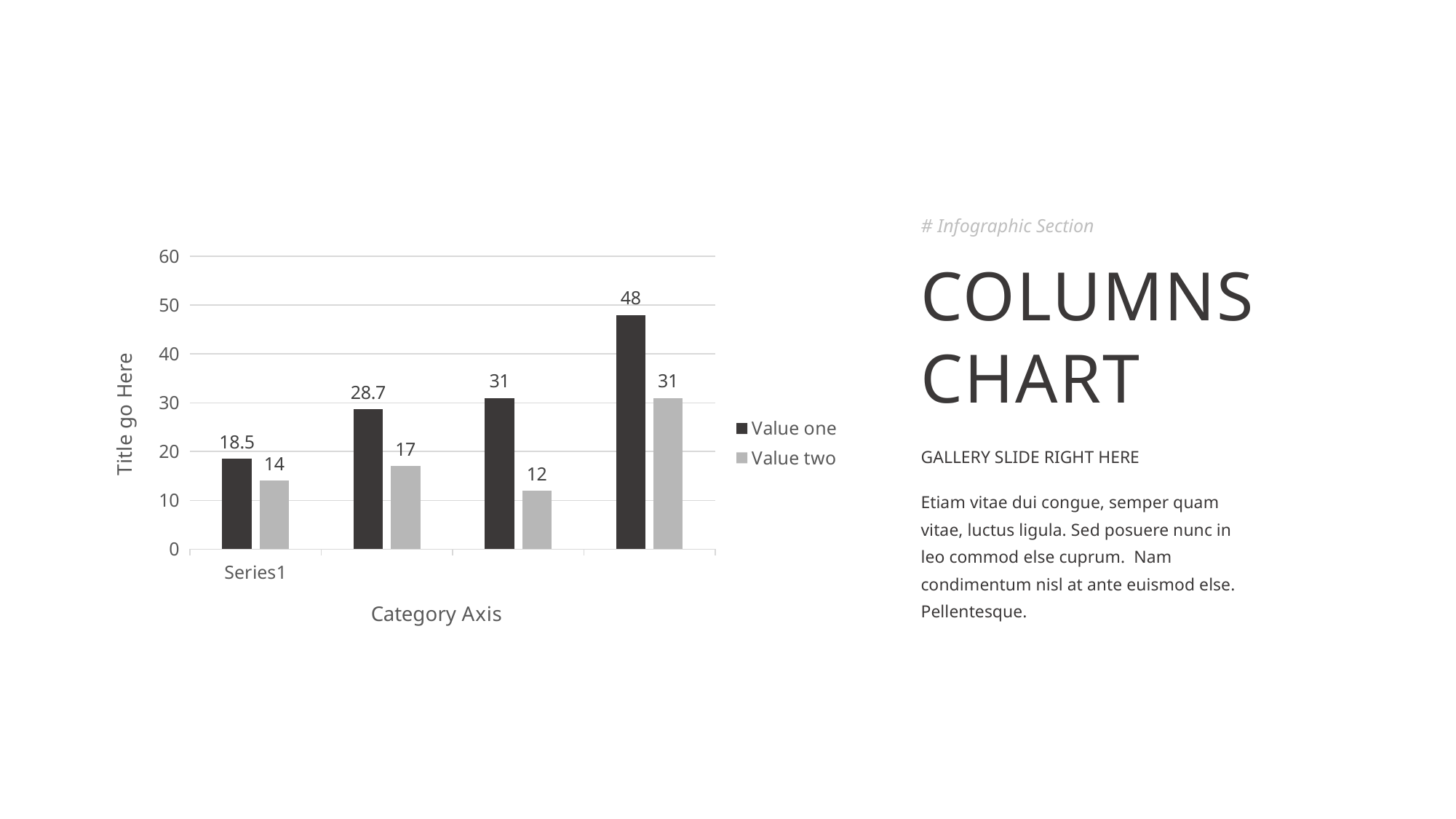
Do the Value one bars rise or fall from left to right across the categories? rise Is the Value one bar for Series1 greater or less than 20? less How many categories (groups of bars) are plotted on the chart? 4 What is the lowest value shown for the Value two series? 12 What is the highest value shown for the Value one series? 48 What is the difference between Value one and Value two for Series1? 4.5 What is the value of Value two for Series1? 14 What is the value of Value one for Series1? 18.5 What kind of chart is shown on the slide? bar chart For Series1, which is larger, Value one or Value two? Value one How many series does the legend list? 2 What is the label of the horizontal axis? Category Axis